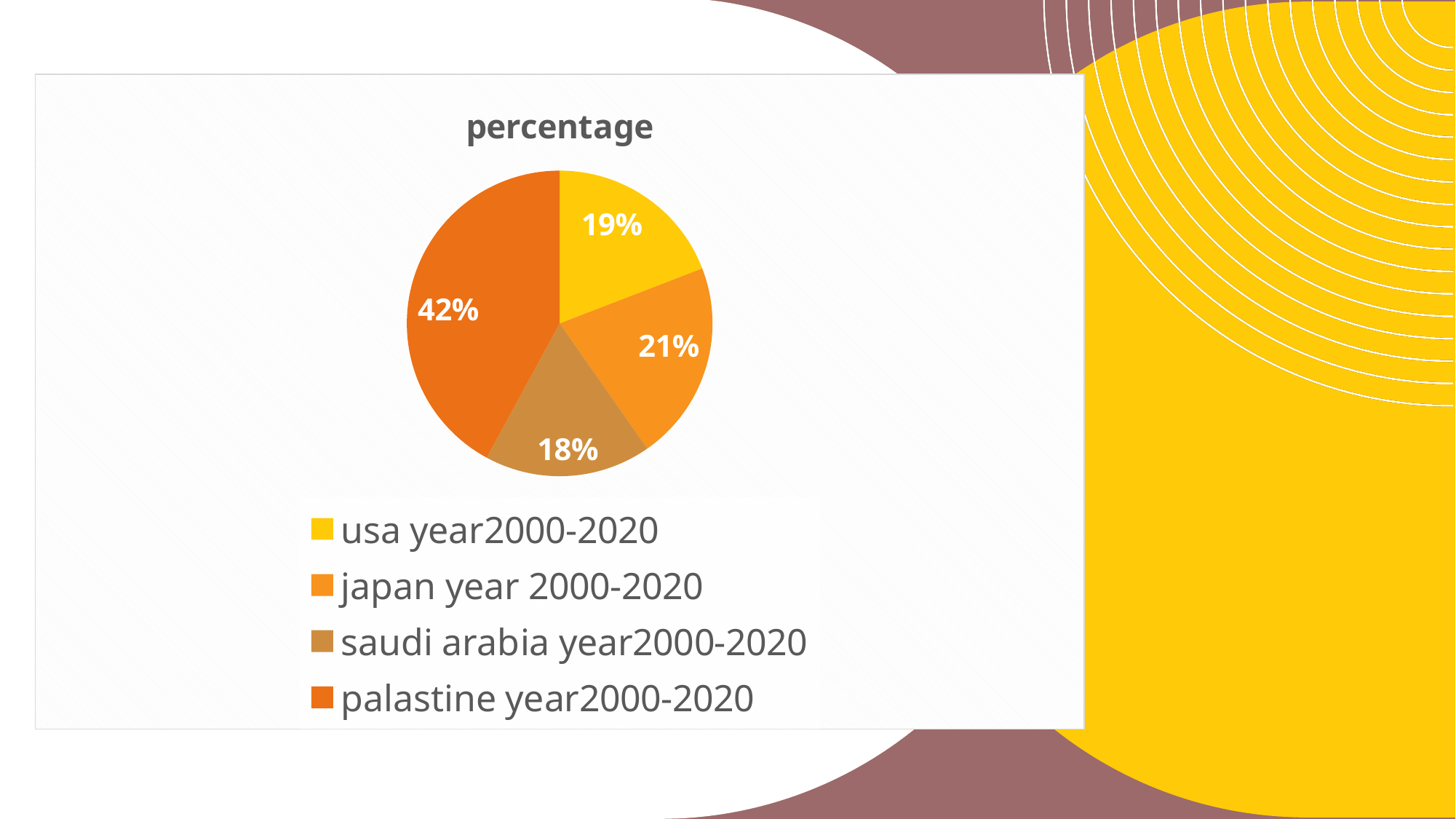
What kind of chart is shown on the slide? pie chart What colour is the slice for palastine year2000-2020? dark orange What percentage is shown for usa year2000-2020? 19% How many slices does the pie chart have? 4 What is the difference in percentage points between palastine year2000-2020 and japan year 2000-2020? 21 Which is larger, the slice for japan year 2000-2020 or the slice for usa year2000-2020? japan year 2000-2020 What percentage is shown for saudi arabia year2000-2020? 18% What percentage is shown for japan year 2000-2020? 21% What is the title of the chart? percentage What percentage is shown for palastine year2000-2020? 42% Which category has the smallest slice of the pie? saudi arabia year2000-2020 Which category has the largest slice of the pie? palastine year2000-2020